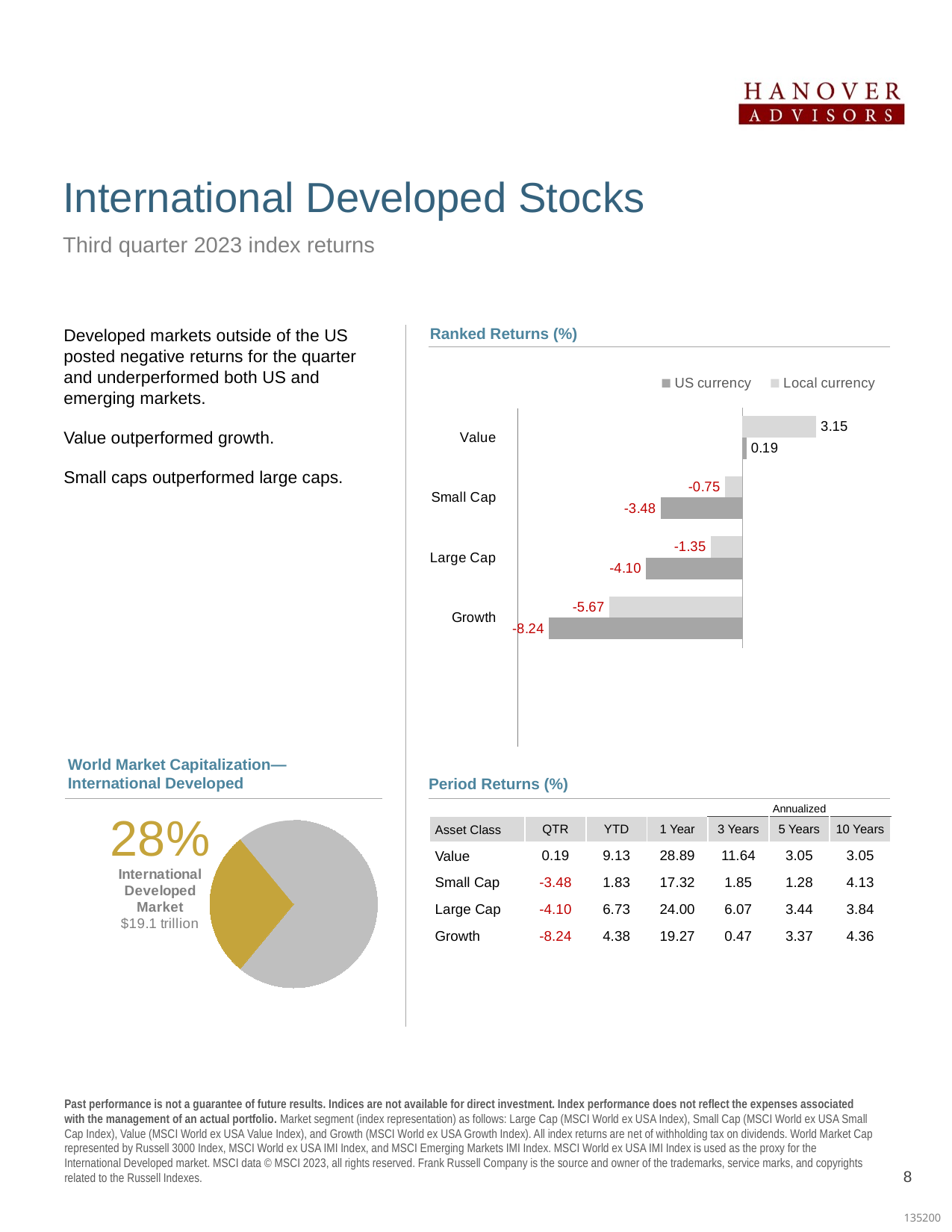
In the Ranked Returns (%) chart, which asset class has the lowest US currency return? Growth In the Ranked Returns (%) chart, which is larger, the US currency return for Small Cap or the US currency return for Large Cap? Small Cap What kind of chart is the World Market Capitalization—International Developed chart? Pie chart In the Ranked Returns (%) chart, what is the US currency return for Value? 0.19 In the Ranked Returns (%) chart, what is the US currency return for Large Cap? -4.10 In the Ranked Returns (%) chart, which asset class has the highest Local currency return? Value In the Ranked Returns (%) chart, what is the difference between the Local currency and US currency returns for Small Cap? 2.73 What kind of chart is the Ranked Returns (%) chart? Bar chart In the World Market Capitalization—International Developed chart, what share of world market capitalization does the International Developed Market represent? 28% In the Ranked Returns (%) chart, what is the Local currency return for Growth? -5.67 How many series does the legend of the Ranked Returns (%) chart list? 2 How many asset classes are shown in the Ranked Returns (%) chart? 4